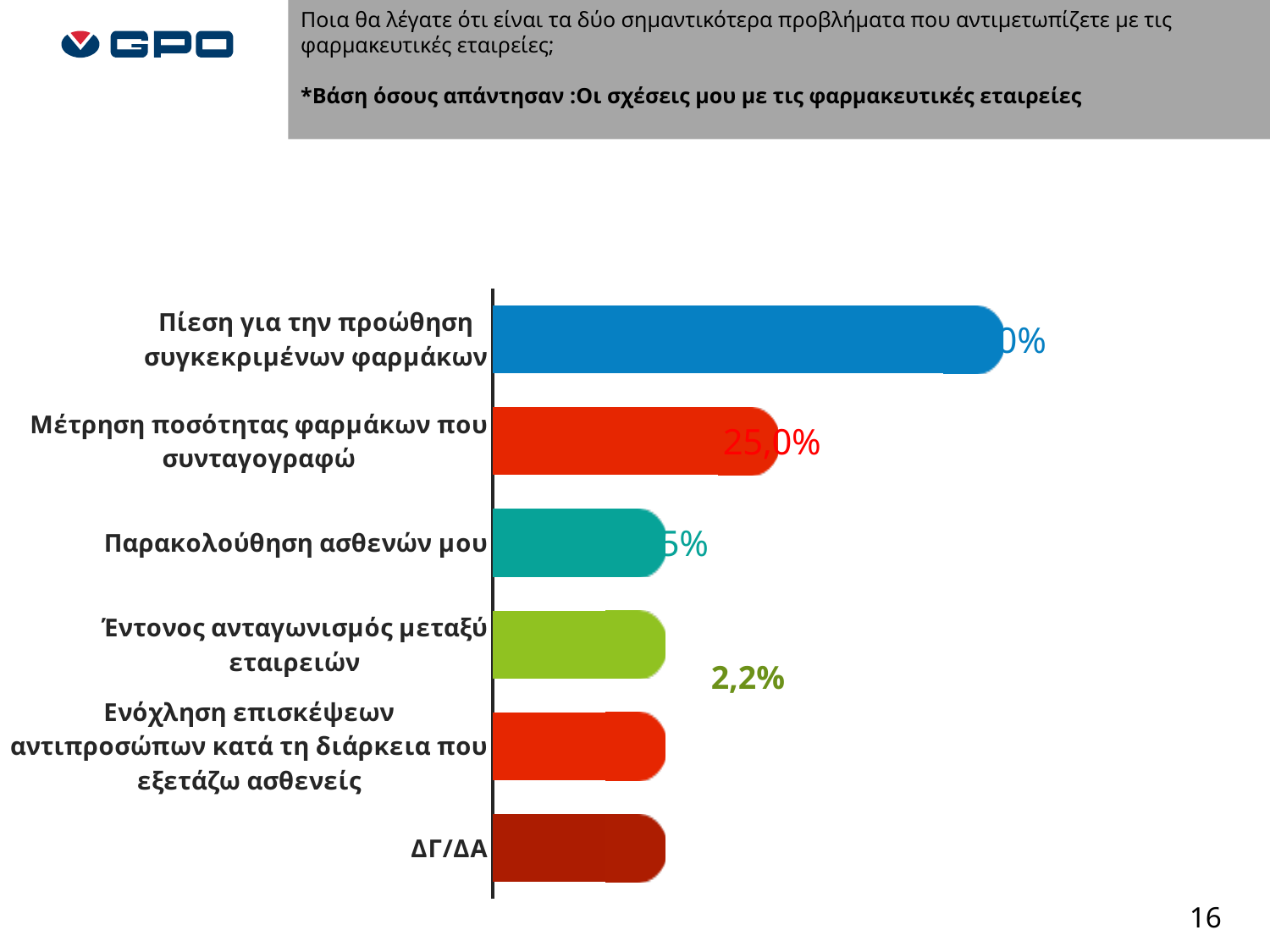
Which category has the highest value in the chart? Πίεση για την προώθηση συγκεκριμένων φαρμάκων How many categories are shown in the bar chart? 6 What is the label of the last (bottom) category in the chart? ΔΓ/ΔΑ What colour is the bar for "Πίεση για την προώθηση συγκεκριμένων φαρμάκων"? blue Which is larger: the value for "Μέτρηση ποσότητας φαρμάκων που συνταγογραφώ" or for "Παρακολούθηση ασθενών μου"? Μέτρηση ποσότητας φαρμάκων που συνταγογραφώ Which is larger: the value for "Πίεση για την προώθηση συγκεκριμένων φαρμάκων" or for "Μέτρηση ποσότητας φαρμάκων που συνταγογραφώ"? Πίεση για την προώθηση συγκεκριμένων φαρμάκων What is the value for "Μέτρηση ποσότητας φαρμάκων που συνταγογραφώ"? 25,0% What type of chart is shown on the slide? bar chart